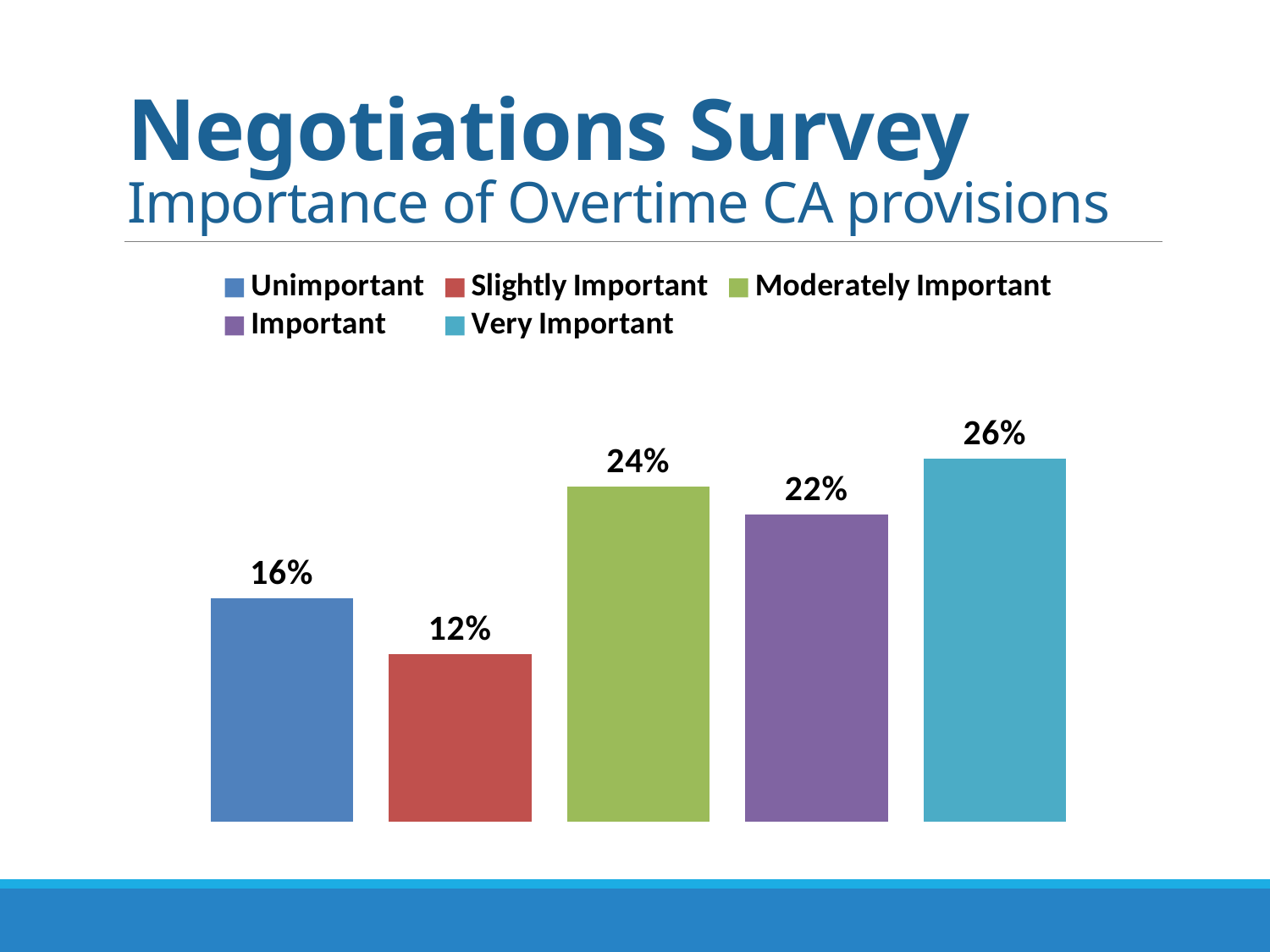
What type of chart is shown on the slide? Bar chart What percentage of respondents rated overtime CA provisions as Unimportant? 16% What is the value for Very Important? 26% What is the value for Moderately Important? 24% How many bars are shown in the chart? 5 What is the value for Slightly Important? 12% Which is larger, the value for Unimportant or the value for Important? Important Which category has the lowest value? Slightly Important What is the difference between the Moderately Important and Important values? 2% What is the difference between the Very Important and Slightly Important values? 14% How many entries does the legend list? 5 Which category has the highest value? Very Important